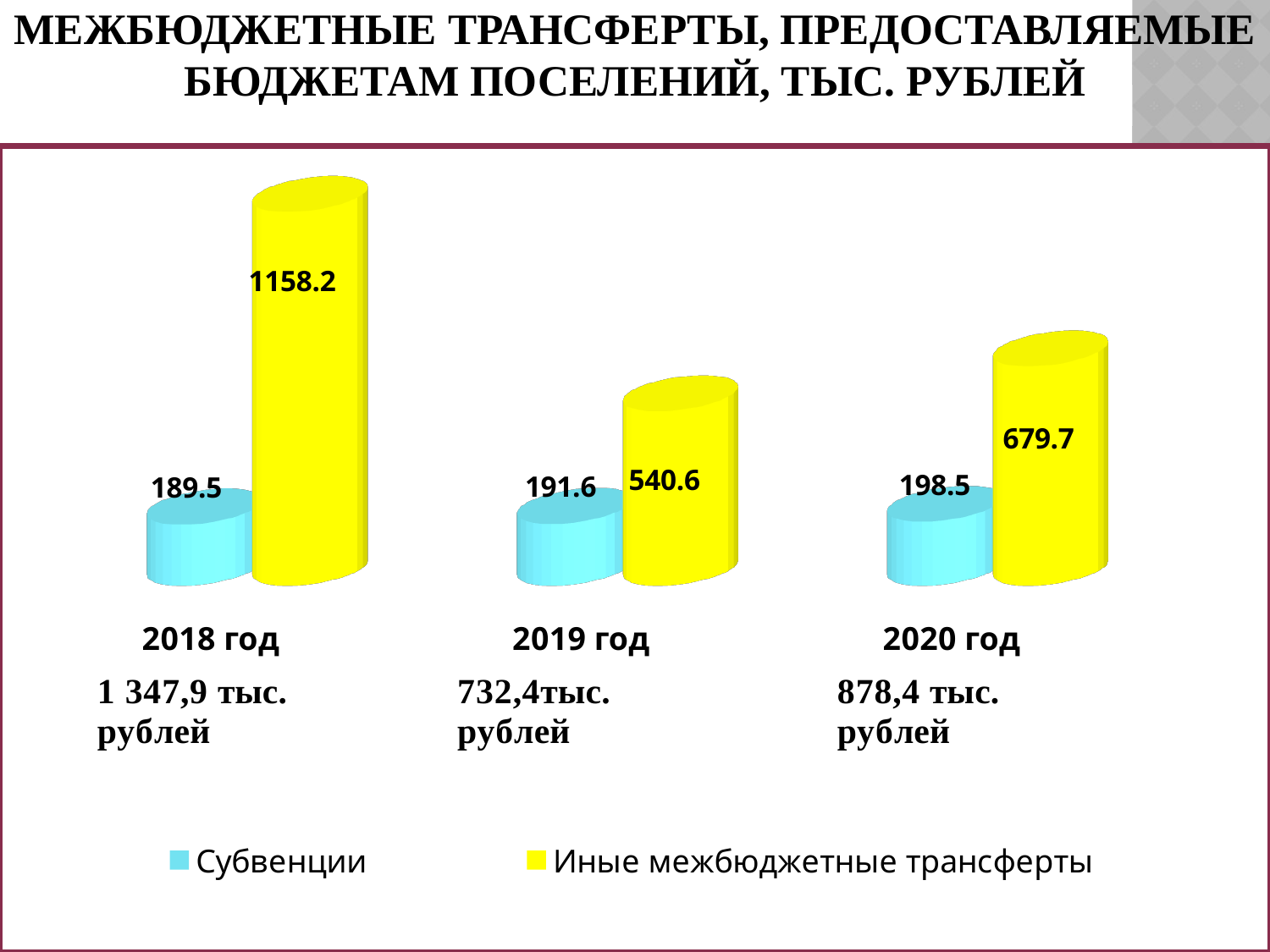
What is the difference between Иные межбюджетные трансферты in 2018 год and 2019 год? 617.6 In which year is the value of Субвенции the lowest? 2018 год In which year is the value of Иные межбюджетные трансферты the highest? 2018 год What total is printed under 2019 год? 732,4 тыс. рублей What kind of chart is shown on the slide? Bar chart Which is larger in 2020 год: Субвенции or Иные межбюджетные трансферты? Иные межбюджетные трансферты What is the value of Субвенции for 2020 год? 198.5 How many series does the legend list? 2 Do the values of Субвенции rise or fall from 2018 год to 2020 год? Rise What is the value of Иные межбюджетные трансферты for 2019 год? 540.6 What is the value of Иные межбюджетные трансферты for 2018 год? 1158.2 How many years are shown on the x axis? 3